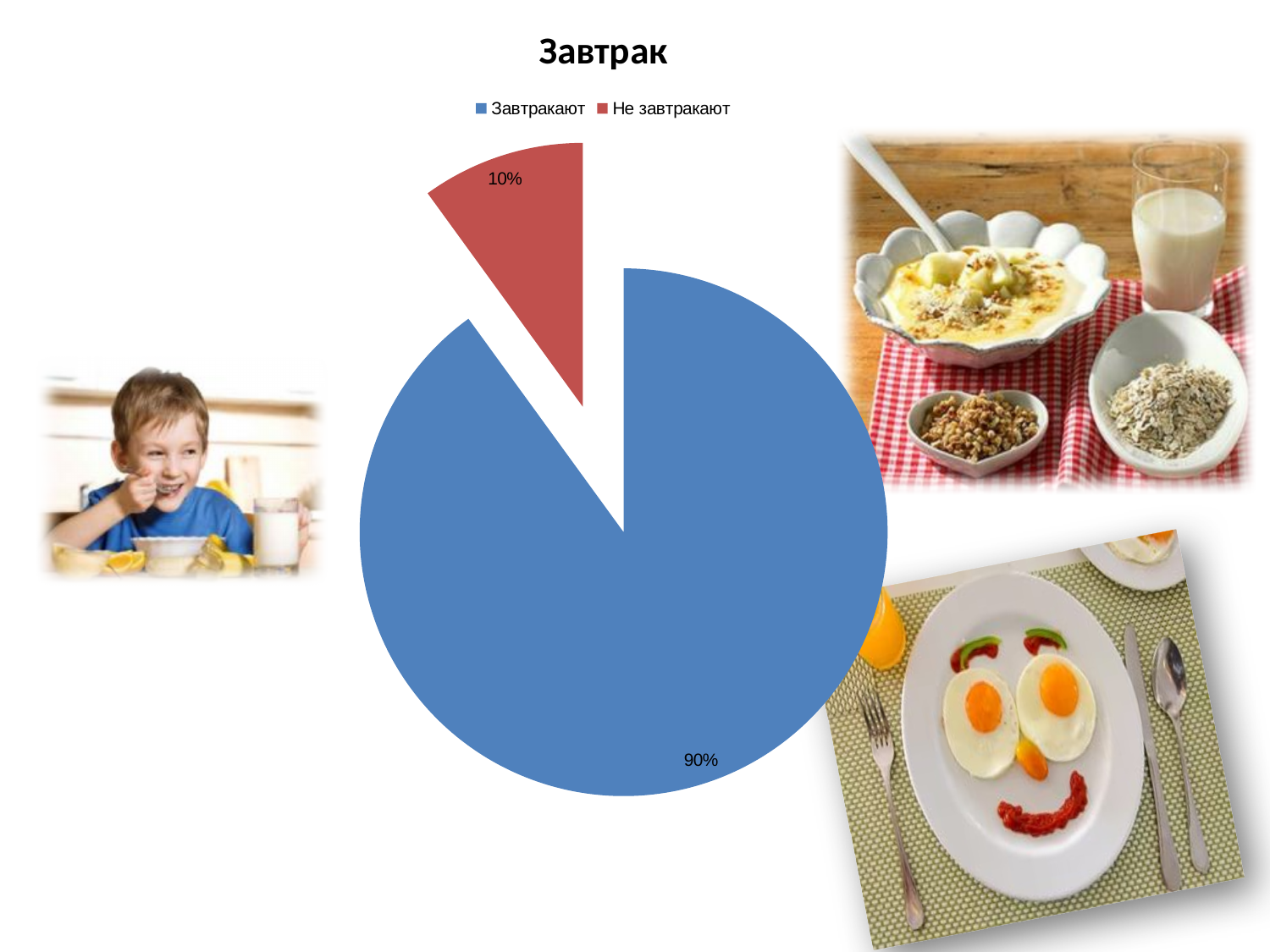
What is the difference in percentage points between the "Завтракают" and "Не завтракают" slices? 80 What colour is the "Не завтракают" slice? red What share of the pie does the "Не завтракают" slice represent? 10% Which is larger, the "Завтракают" slice or the "Не завтракают" slice? Завтракают How many entries does the legend list? 2 What type of chart is shown on the slide? pie chart What is the title of the chart? Завтрак Which category has the largest slice of the pie? Завтракают Which category has the smallest slice of the pie? Не завтракают What share of the pie does the "Завтракают" slice represent? 90% How many categories does the pie chart show? 2